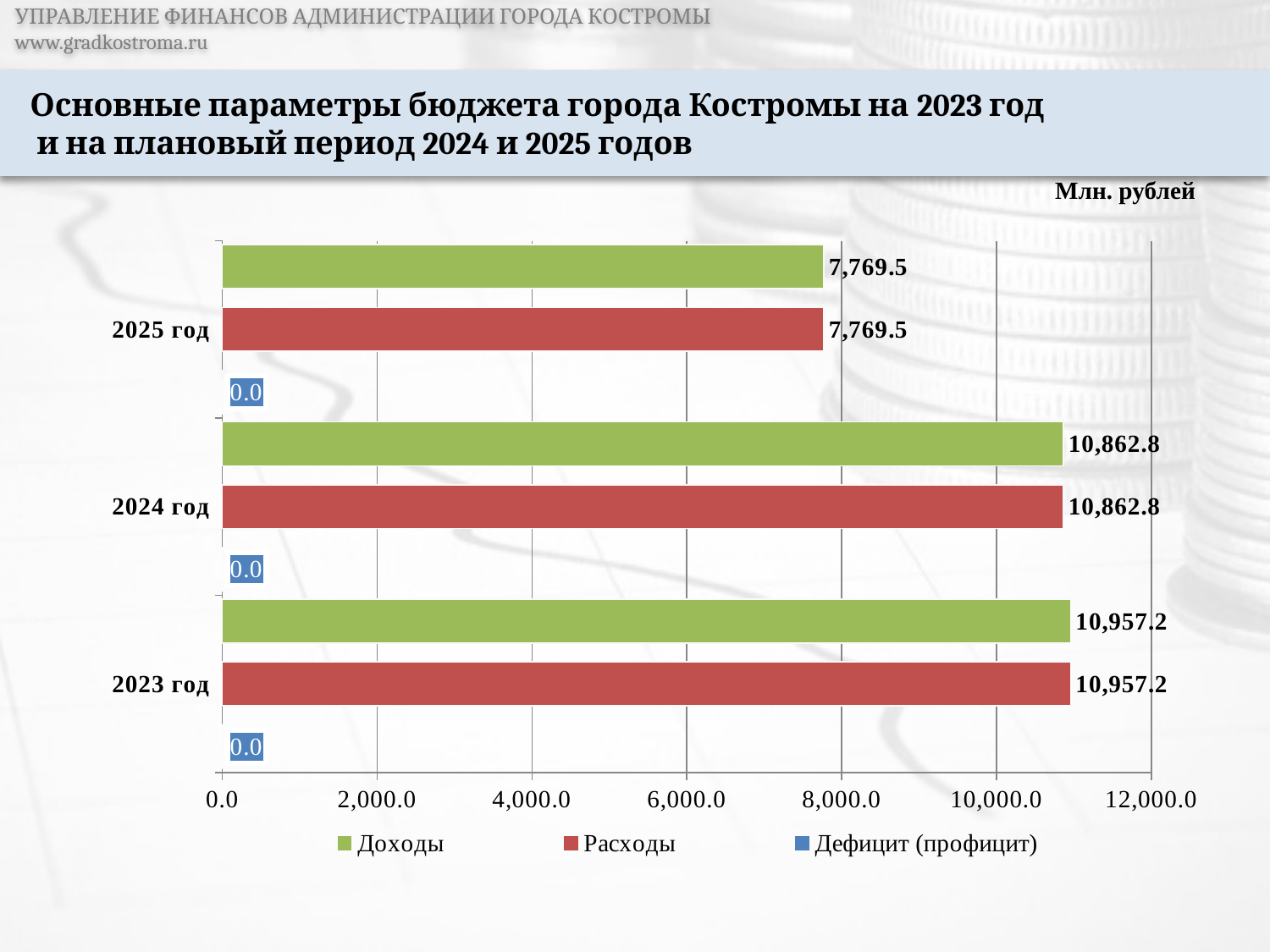
Which is larger: Расходы for 2023 год or Расходы for 2024 год? Расходы for 2023 год What is the difference between Доходы for 2024 год and Доходы for 2025 год? 3,093.3 What is the value of Расходы for 2024 год? 10,862.8 What is the value of Доходы for 2023 год? 10,957.2 How many series does the legend list? 3 What is the value of Дефицит (профицит) for 2024 год? 0.0 Is the value of Доходы for 2025 год greater or less than 8,000.0? less What kind of chart is shown on the slide? bar chart What is the value of Доходы for 2025 год? 7,769.5 How many years are shown on the chart? 3 Which year has the lowest value of Расходы? 2025 год Which year has the highest value of Доходы? 2023 год